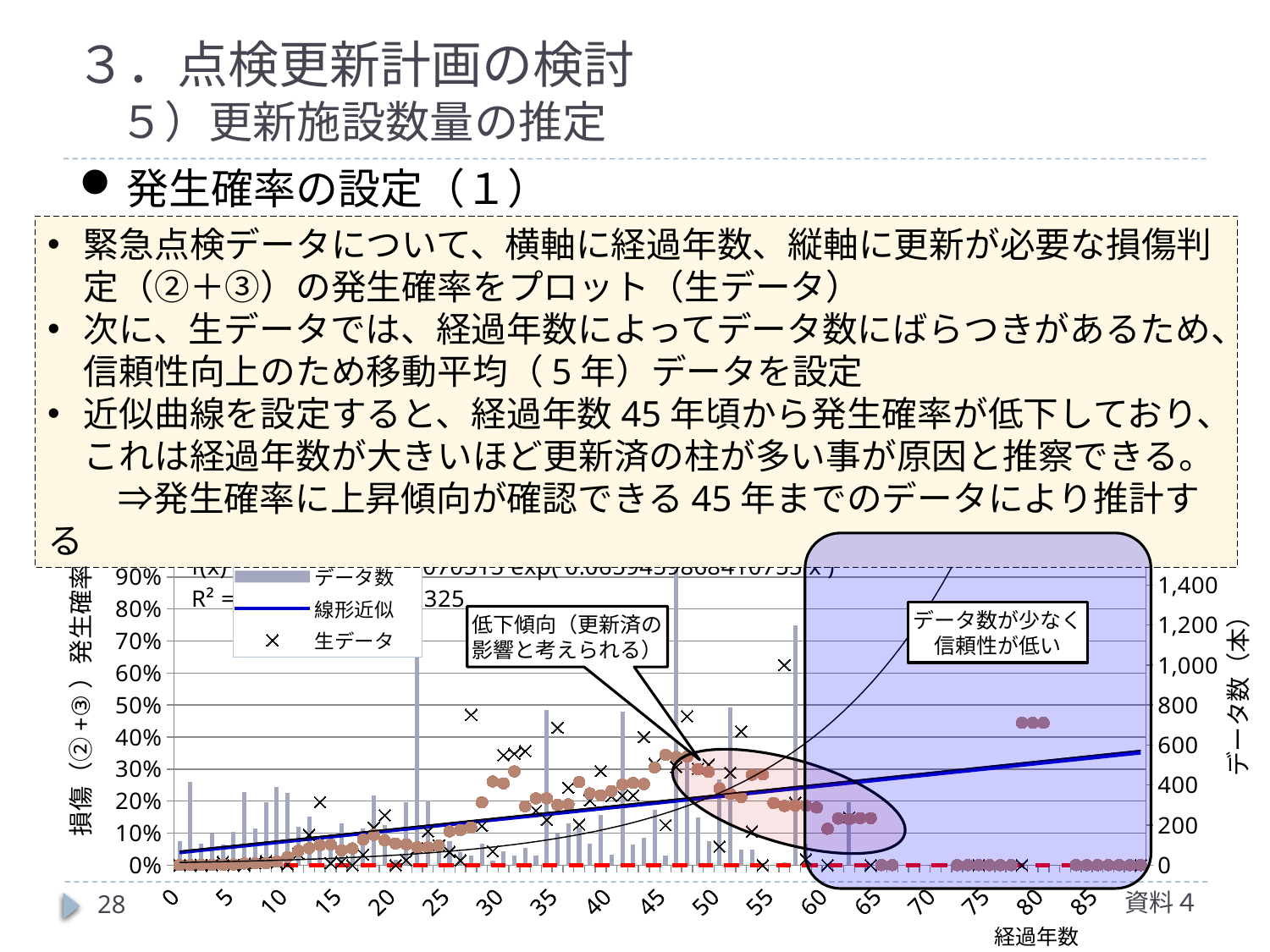
Is the 線形近似 line value at 経過年数 85 greater or less than 30%? greater What kind of chart is shown on the slide? A combination chart with bars, a line and scatter points What is the label of the right-hand vertical axis of the chart? データ数（本） What is the highest tick value shown on the right vertical axis of the chart? 1,400 Which is larger, the 生データ value at 経過年数 28 or at 経過年数 14? 経過年数 28 What is the highest tick value shown on the left vertical axis of the chart? 90% What is the last tick value shown on the horizontal axis of the chart? 85 What is the label of the horizontal axis of the chart? 経過年数 Does the 線形近似 line rise or fall as 経過年数 increases? rise